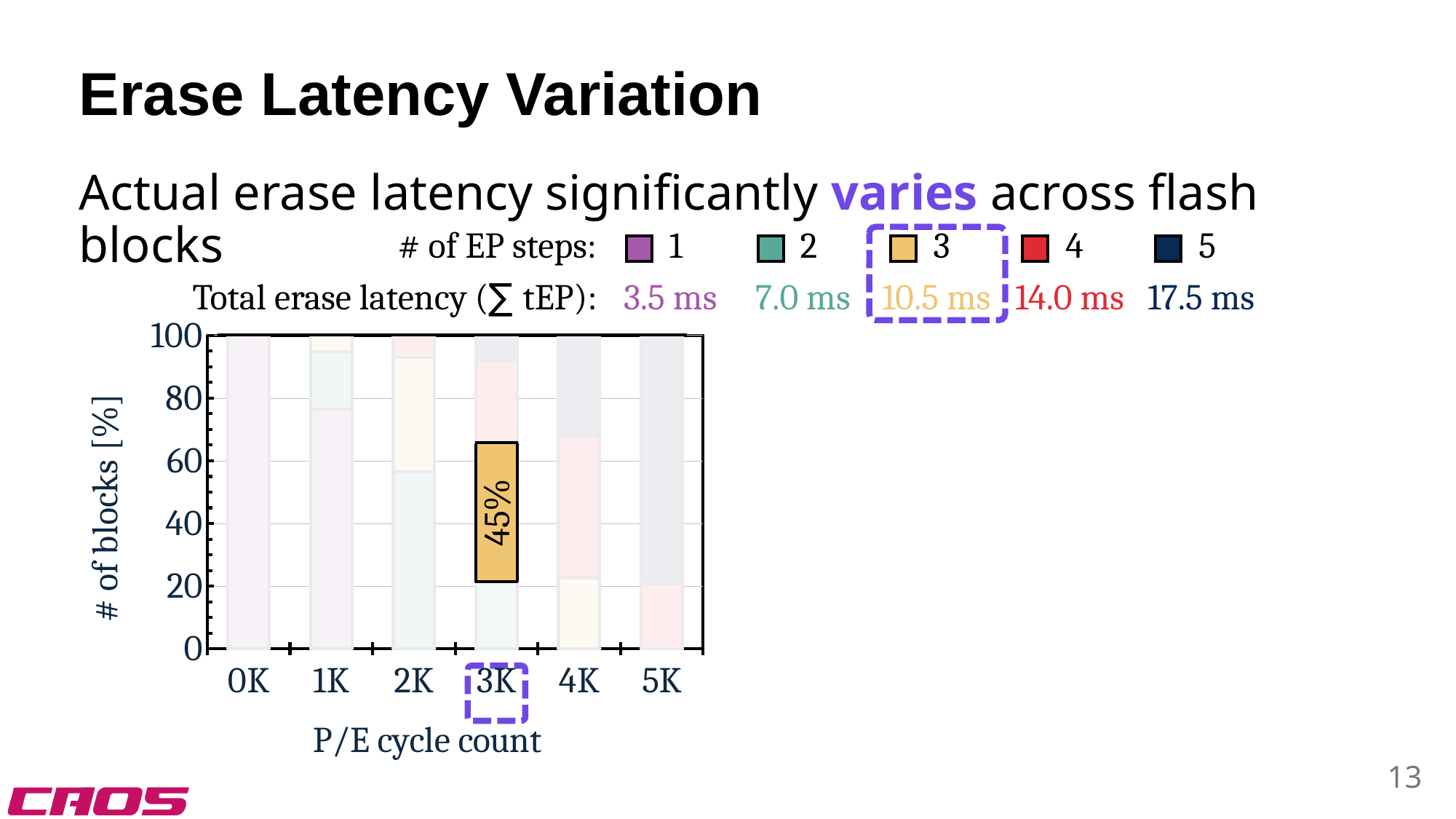
Is the share of blocks with 1 EP step at 0K greater or less than 80%? greater As the P/E cycle count increases from 0K to 5K, does the share of blocks requiring only 1 EP step rise or fall? Fall How many series (numbers of EP steps) does the legend list? 5 How many P/E cycle count categories are shown on the x axis? 6 What percentage of blocks require 3 EP steps at a P/E cycle count of 3K? 45% Is the share of blocks with 5 EP steps at 5K greater or less than 60%? greater What is the label of the y axis? # of blocks [%] Which P/E cycle count has the largest share of blocks requiring 1 EP step? 0K What kind of chart is shown on the slide? Stacked bar chart According to the legend, what is the total erase latency for 3 EP steps? 10.5 ms Which P/E cycle count has the largest share of blocks requiring 5 EP steps? 5K Is the share of blocks with 2 EP steps at 2K greater or less than 40%? greater